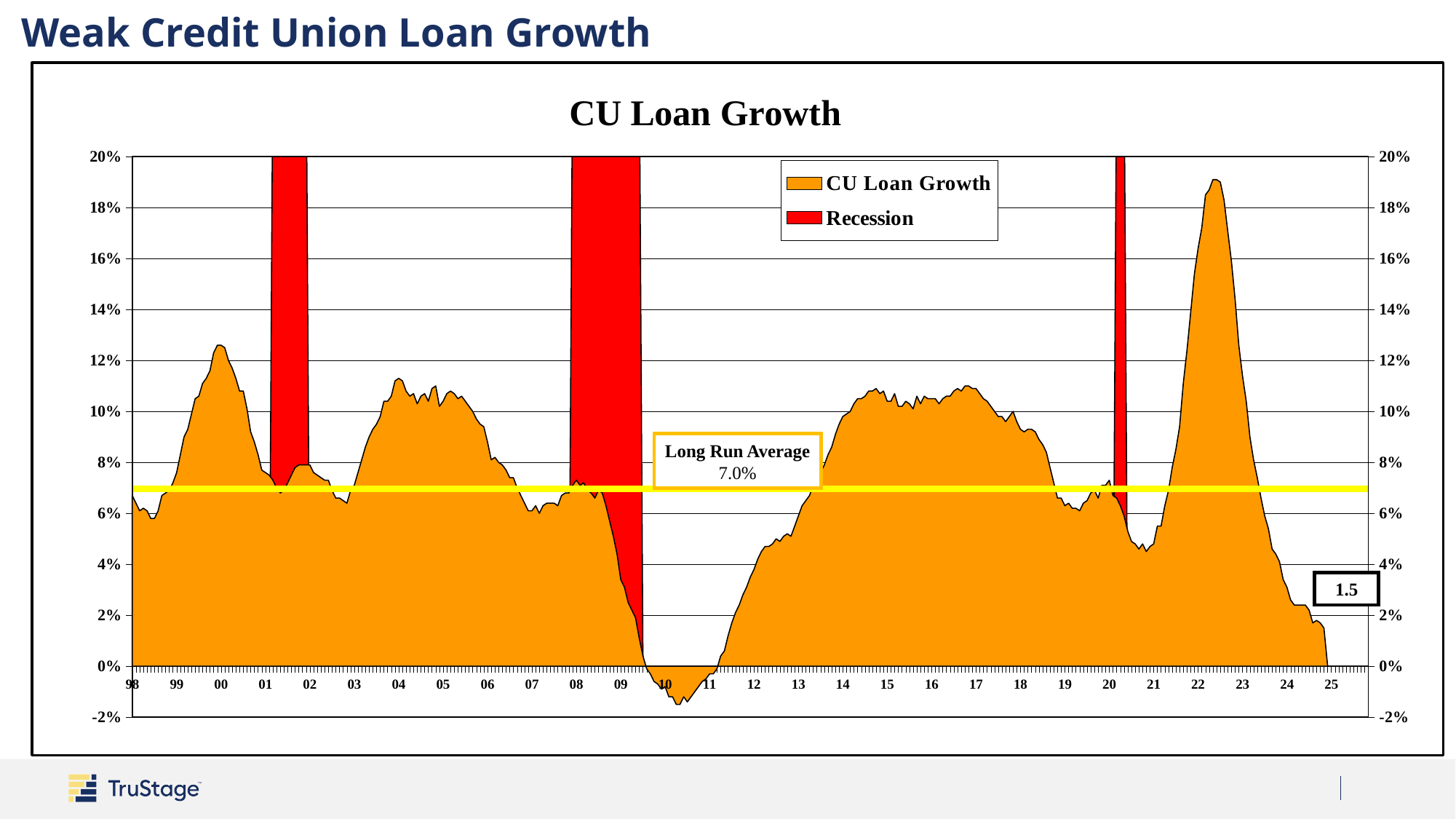
Around which year does CU loan growth reach its lowest point? 10 Around which year does CU loan growth reach its highest point? 22 Does CU loan growth rise or fall from 2022 to 2025? fall Is the CU loan growth value around 2010 greater or less than 0%? less How many series does the legend list? 2 What is the most recent CU loan growth value labeled at the right end of the chart? 1.5 What is the title of the chart? CU Loan Growth How many recession periods are shaded on the chart? 3 What kind of chart is shown on the slide? Area chart Is the peak CU loan growth value around 2022 greater or less than 18%? greater What is the long run average of CU loan growth shown on the chart? 7.0%